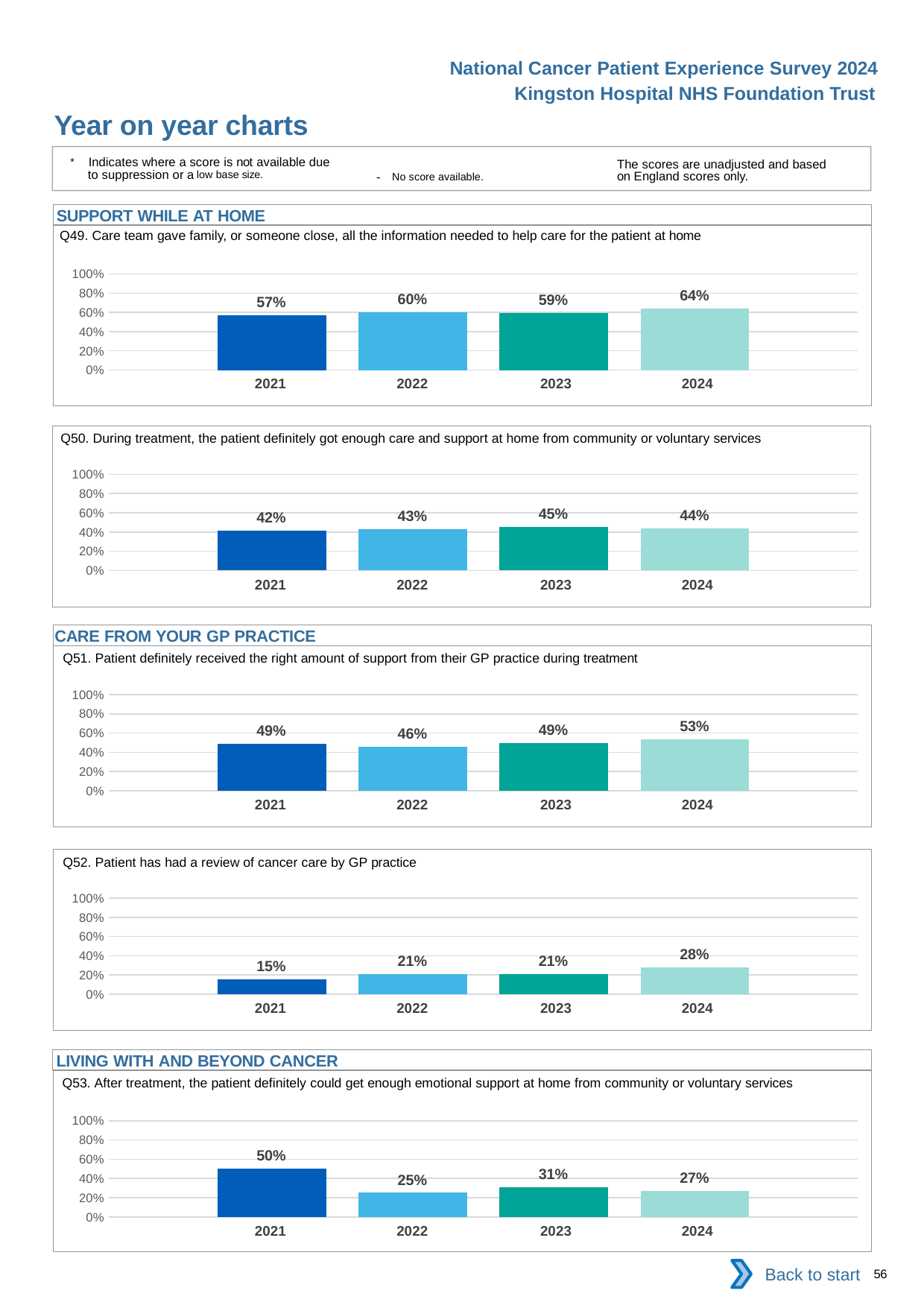
How many years are shown in the Q52 chart? 4 In the Q53 chart, which is larger, the value for 2021 or the value for 2023? 2021 What kind of chart is the Q49 chart? bar chart In the Q52 chart, what is the value for 2021? 15% In the Q49 chart, which year has the lowest value? 2021 In the Q52 chart, what is the difference between the 2024 and 2021 values? 13% In the Q51 chart, what is the value for 2022? 46% In the Q50 chart, what is the value for 2023? 45% In the Q53 chart, is the value for 2021 greater or less than 40%? greater In the Q51 chart, which year has the highest value? 2024 In the Q49 chart, what is the value for 2024? 64% In the Q50 chart, what is the difference between the 2023 and 2021 values? 3%